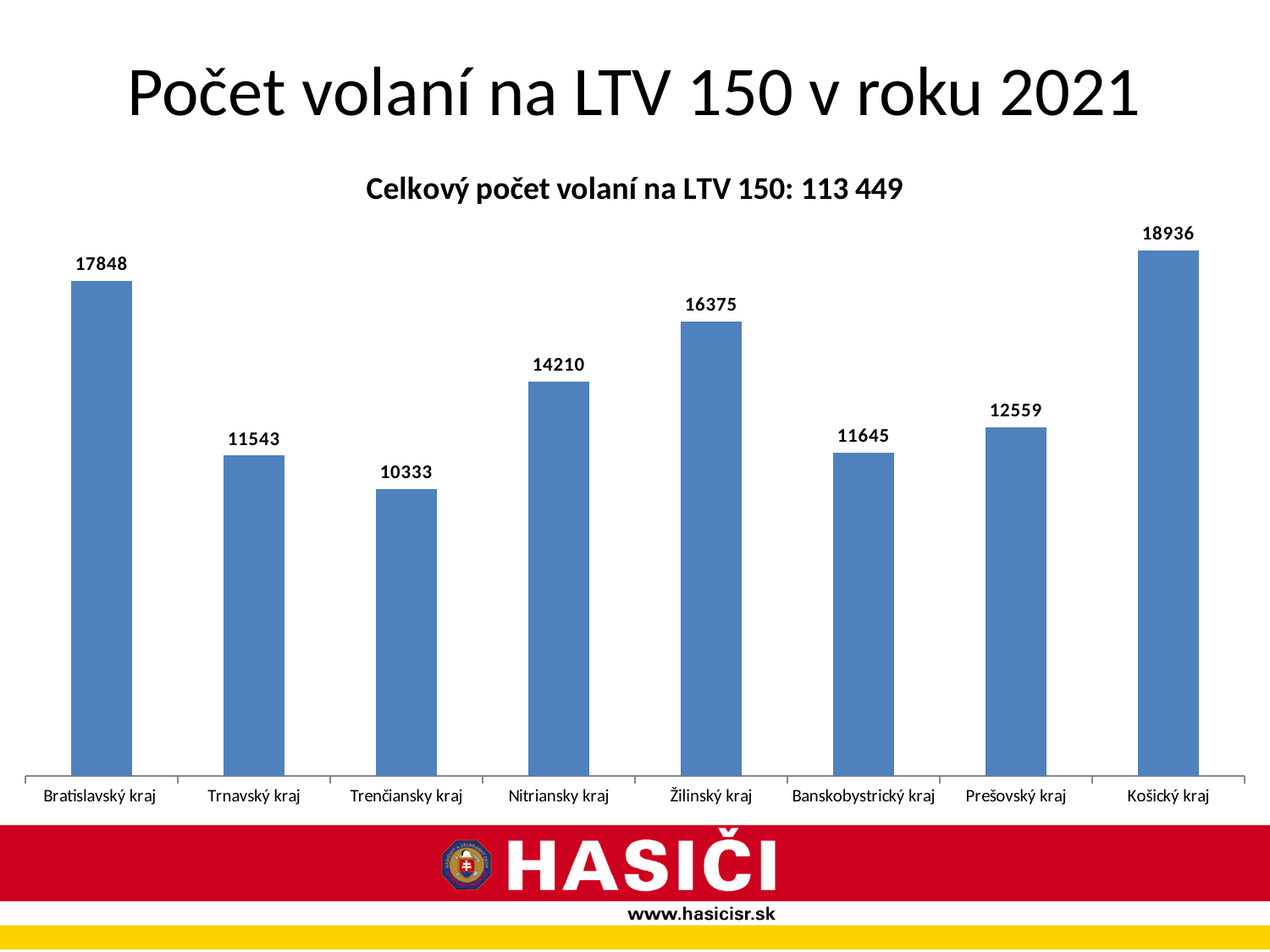
What kind of chart is shown on the slide? Bar chart What is the value for Žilinský kraj? 16375 What is the chart's title? Celkový počet volaní na LTV 150: 113 449 What is the value for Trenčiansky kraj? 10333 What is the value for Bratislavský kraj? 17848 Which is larger, the value for Banskobystrický kraj or the value for Prešovský kraj? Prešovský kraj Which region has the lowest number of calls? Trenčiansky kraj How many regions are shown on the chart? 8 What is the difference between the values for Nitriansky kraj and Trnavský kraj? 2667 What is the value for Prešovský kraj? 12559 Which region has the highest number of calls? Košický kraj What is the difference between the values for Košický kraj and Bratislavský kraj? 1088